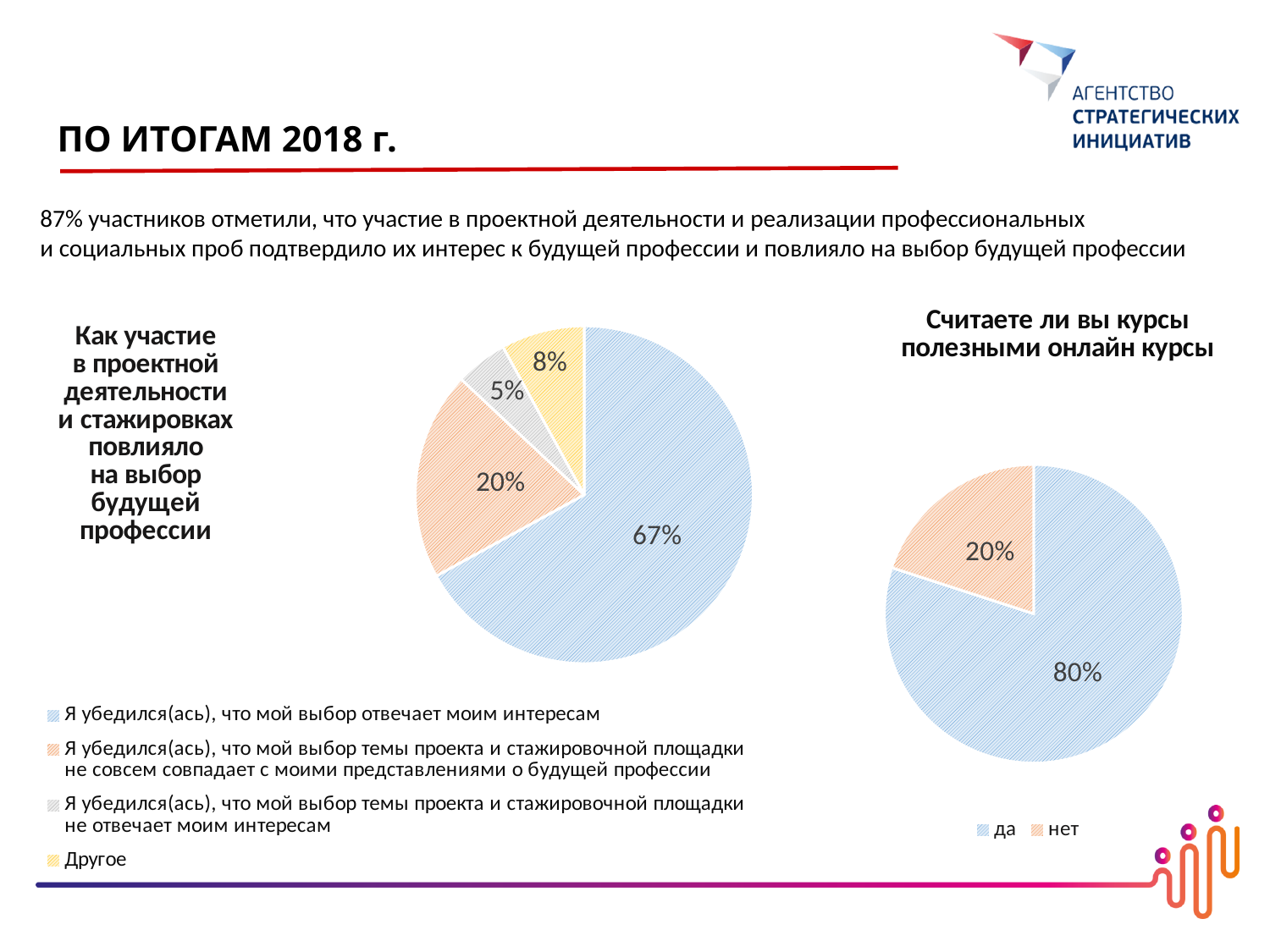
In the left pie chart, what is the difference between the largest slice (67%) and the 20% slice? 47% In the left pie chart, how many slices are there? 4 What type of chart is used for the right chart (Считаете ли вы курсы полезными онлайн курсы)? Pie chart In the right pie chart (Считаете ли вы курсы полезными онлайн курсы), what share answered 'да'? 80% How many entries does the legend of the right pie chart list? 2 In the left pie chart, which legend category has the smallest slice? Я убедился(ась), что мой выбор темы проекта и стажировочной площадки не отвечает моим интересам In the left pie chart, what share is shown for 'Я убедился(ась), что мой выбор темы проекта и стажировочной площадки не отвечает моим интересам'? 5% In the left pie chart, what share is shown for 'Другое'? 8% In the left pie chart (Как участие в проектной деятельности и стажировках повлияло на выбор будущей профессии), what share is shown for 'Я убедился(ась), что мой выбор отвечает моим интересам'? 67% In the left pie chart, which legend category has the largest slice? Я убедился(ась), что мой выбор отвечает моим интересам In the right pie chart, which is larger, 'да' or 'нет'? да In the right pie chart, what share answered 'нет'? 20%